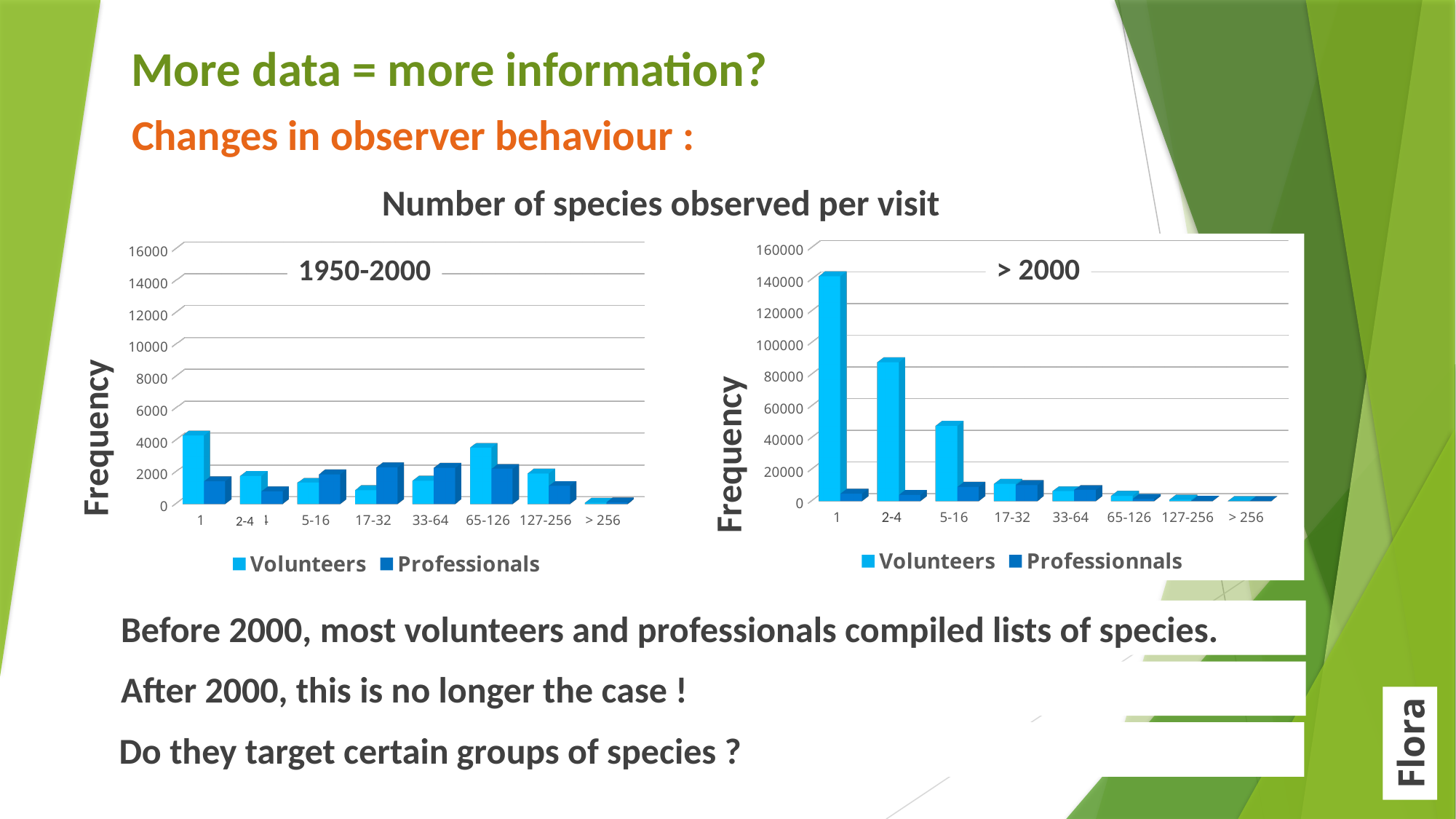
In the "> 2000" chart, do the Volunteers values rise or fall from category 1 to category 17-32? fall What is the shared title above the two charts? Number of species observed per visit In the "1950-2000" chart, is the Volunteers value for category 1 greater or less than 4000? greater In the "1950-2000" chart, which category has the highest Volunteers value? 1 In the "1950-2000" chart, is the Professionals value for category 17-32 greater or less than 2000? greater How many categories are shown on the x axis of the "> 2000" chart? 8 In the "> 2000" chart, which category has the highest Volunteers value? 1 What kind of chart is the "1950-2000" chart? bar chart In the "1950-2000" chart, which is larger for category 17-32: Volunteers or Professionals? Professionals In the "> 2000" chart, which is larger for category 2-4: Volunteers or Professionnals? Volunteers How many series does the legend of the "> 2000" chart list? 2 In the "> 2000" chart, is the Volunteers value for category 1 greater or less than 120000? greater